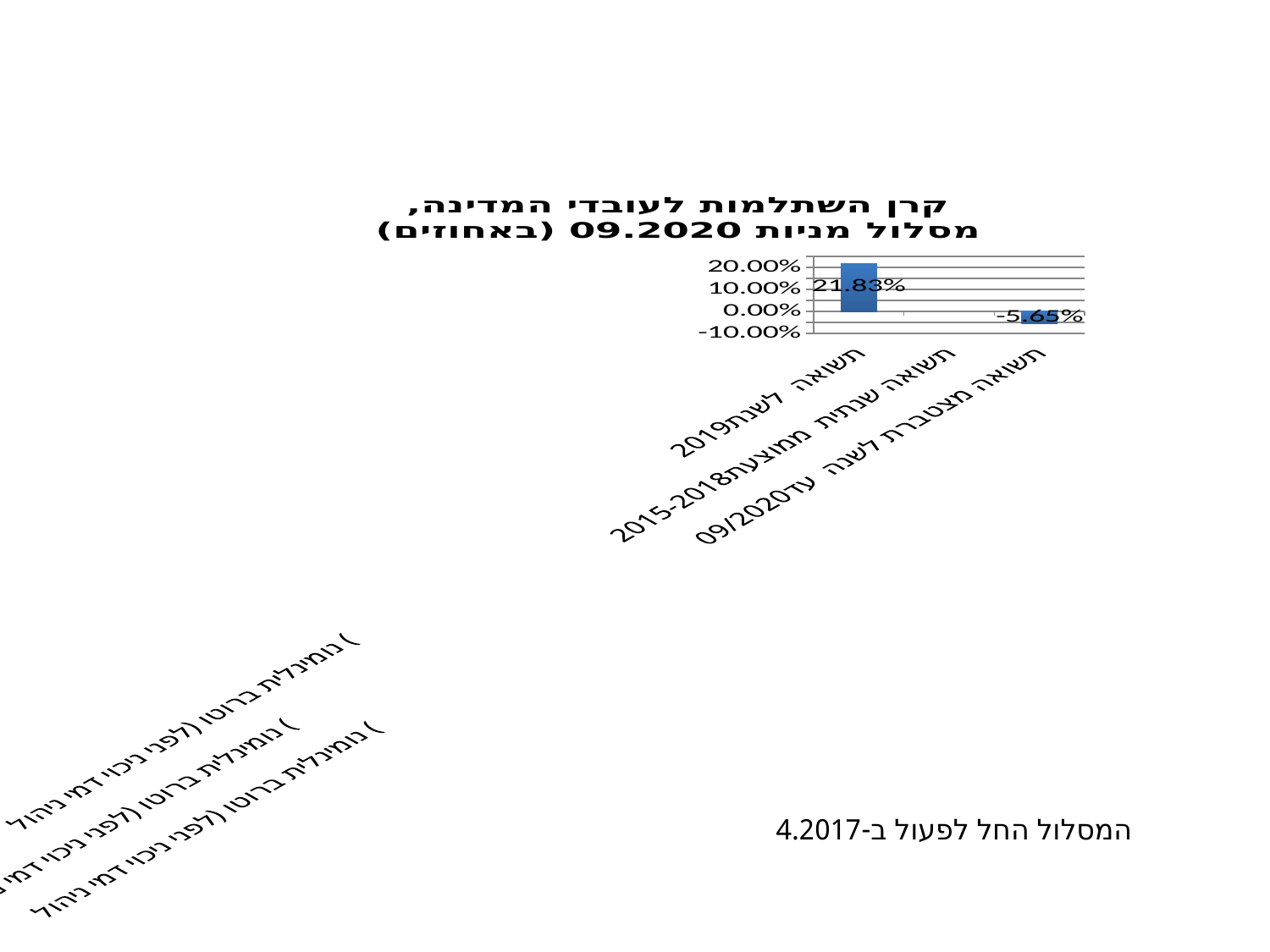
Is the value for the 2019 return greater or less than 20.00%? greater Which category has the highest value in the chart? תשואה לשנת 2019 Which is larger: the 2019 return or the cumulative return to 09/2020? תשואה לשנת 2019 Which category with a plotted bar has the lowest value? תשואה מצטברת לשנה עד 09/2020 What is the difference between the 2019 return (21.83%) and the cumulative return to 09/2020 (-5.65%)? 27.48% What kind of chart is shown on the slide? bar chart What is the lowest value shown on the y axis of the chart? -10.00% What is the value shown for the cumulative return for the year to 09/2020 (תשואה מצטברת לשנה עד 09/2020)? -5.65% Is the value for the cumulative return to 09/2020 greater or less than 0.00%? less What is the highest value shown on the y axis of the chart? 20.00% How many categories are shown on the x axis of the chart? 3 What is the value shown for the 2019 return (תשואה לשנת 2019)? 21.83%